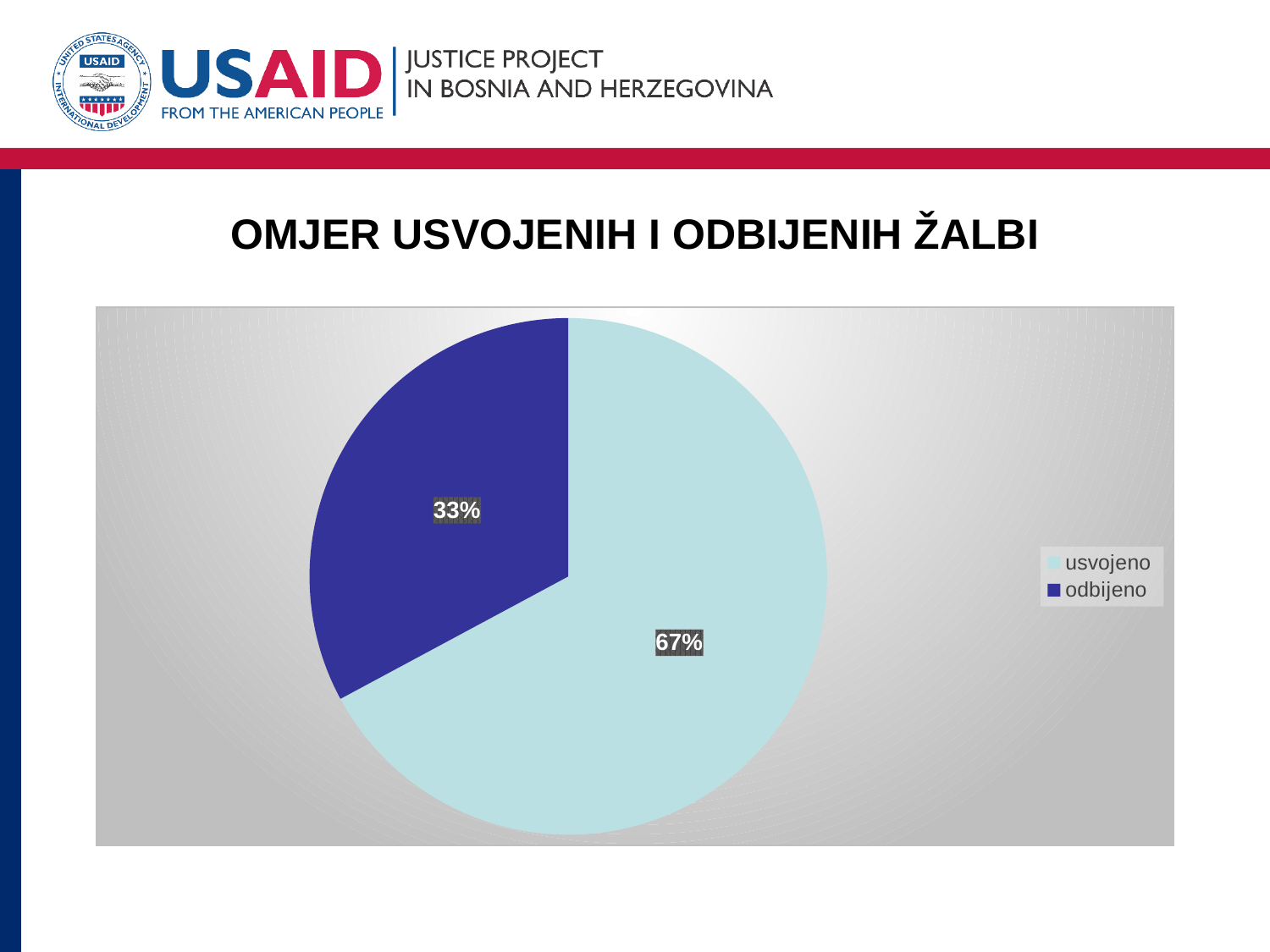
How many slices does the pie chart have? 2 Which slice is the largest in the pie chart? usvojeno What is the difference in percentage points between the 'usvojeno' and 'odbijeno' slices? 34 percentage points Which legend entry is shown in dark blue? odbijeno What kind of chart is shown on the slide? pie chart What is the title of the chart on the slide? OMJER USVOJENIH I ODBIJENIH ŽALBI Which slice is the smallest in the pie chart? odbijeno What share of the pie does the 'usvojeno' slice represent? 67% Which is larger, the 'usvojeno' slice or the 'odbijeno' slice? usvojeno How many entries does the legend list? 2 What share of the pie does the 'odbijeno' slice represent? 33%